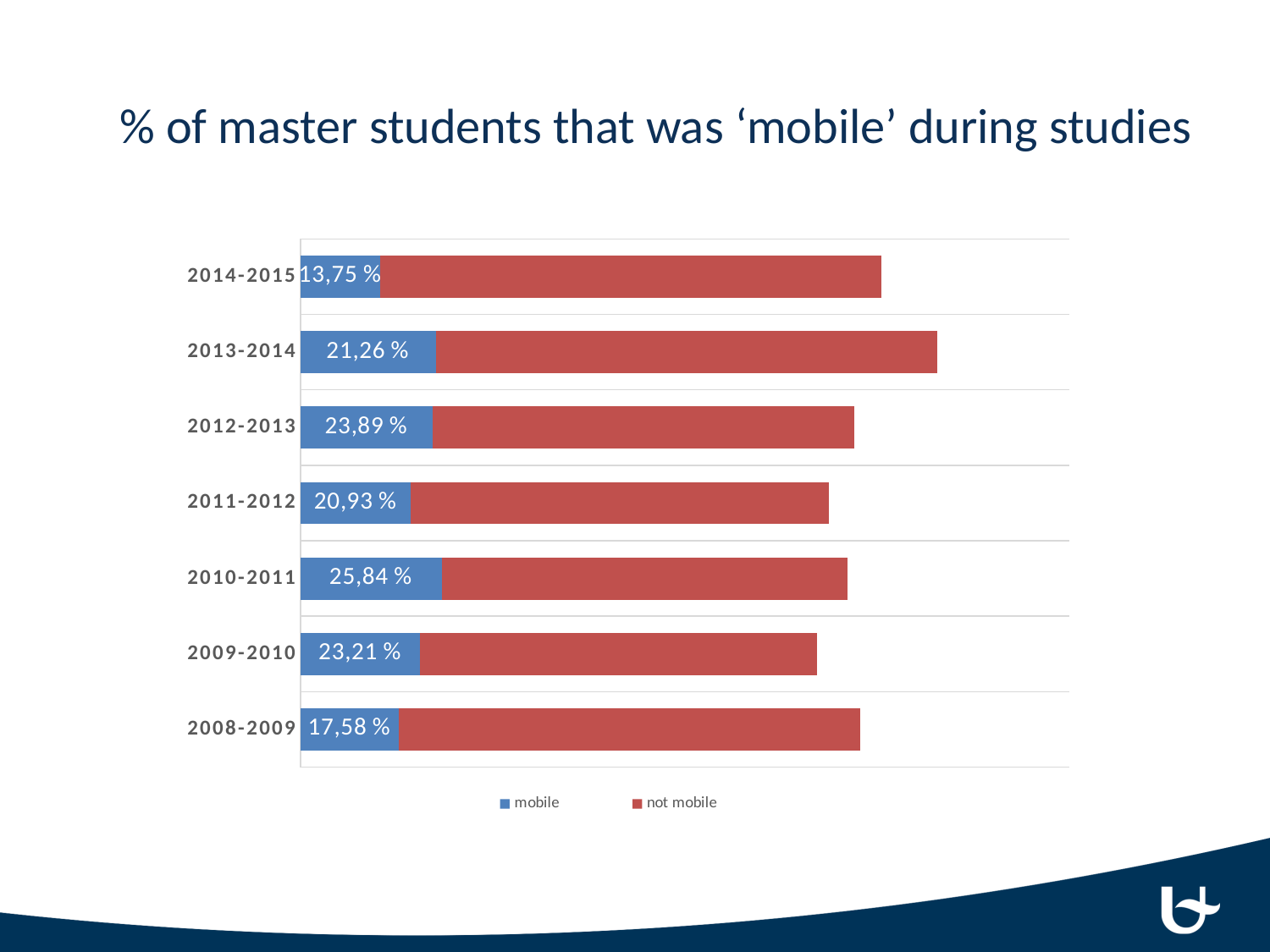
What is the difference between the 'mobile' values for 2013-2014 and 2014-2015? 7,51 % What is the 'mobile' value for 2012-2013? 23,89 % What is the 'mobile' value for 2010-2011? 25,84 % Which has a larger 'mobile' value, 2009-2010 or 2011-2012? 2009-2010 Which academic year has the lowest 'mobile' percentage? 2014-2015 What percentage of master students was mobile in 2014-2015? 13,75 % What kind of chart is shown on the slide? Stacked bar chart What is the 'mobile' value for 2008-2009? 17,58 % Which colour represents the 'not mobile' series? Red Which academic year has the highest 'mobile' percentage? 2010-2011 How many academic years are shown on the chart? 7 How many series does the legend list? 2